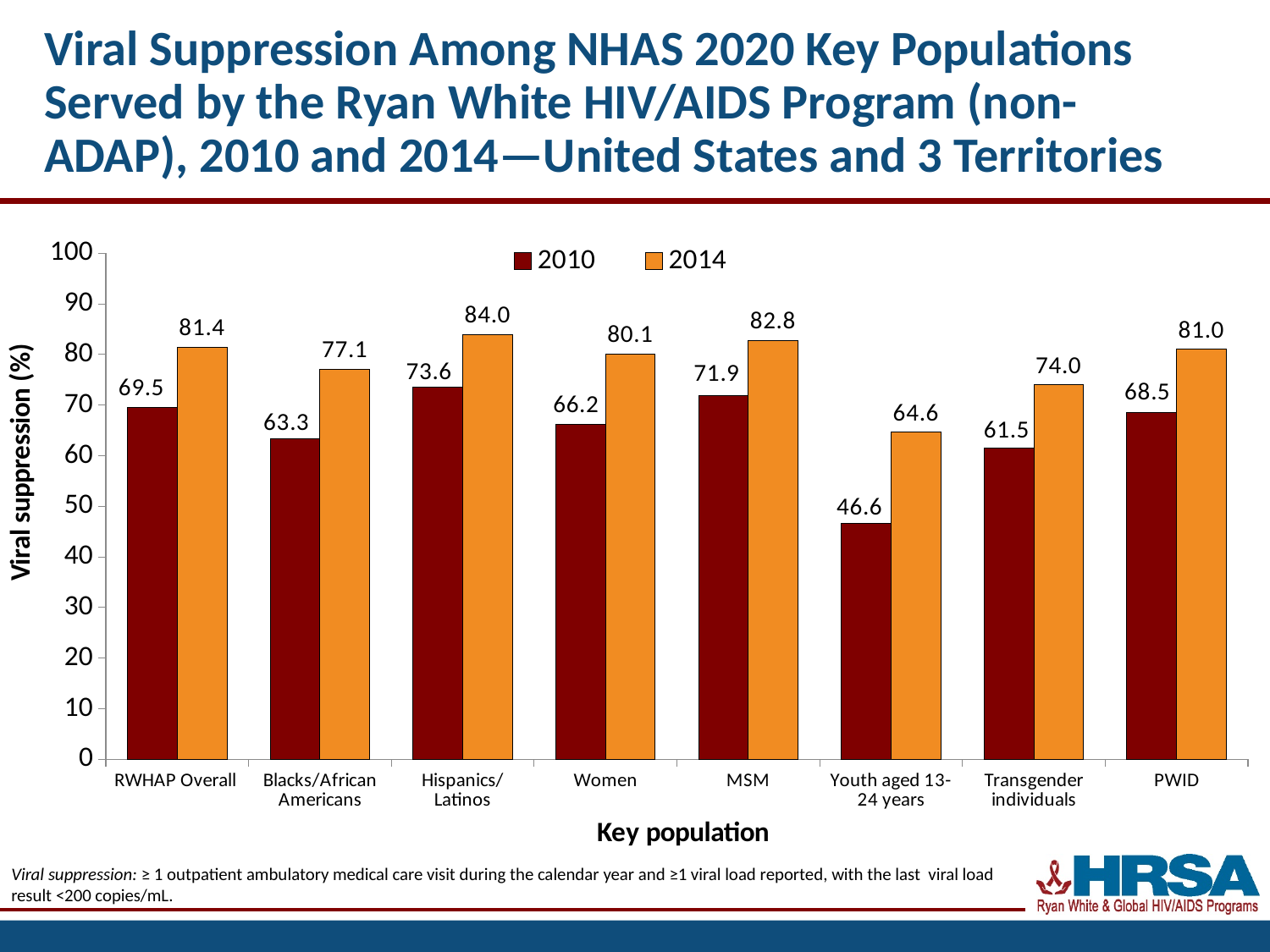
What type of chart is shown on the slide? Bar chart How many key populations are shown on the x axis? 8 What was the viral suppression percentage for Transgender individuals in 2014? 74.0 Which key population had the lowest viral suppression in 2010? Youth aged 13-24 years Which key population had the highest viral suppression in 2014? Hispanics/Latinos What is the difference between the 2014 and 2010 viral suppression values for Youth aged 13-24 years? 18.0 What was the viral suppression percentage for Women in 2014? 80.1 Is the 2010 viral suppression value for Blacks/African Americans greater or less than 70? less What was the viral suppression percentage for Youth aged 13-24 years in 2010? 46.6 Which had a higher viral suppression in 2010: MSM or PWID? MSM What is the difference between the 2014 and 2010 viral suppression values for RWHAP Overall? 11.9 How many series does the legend list? 2